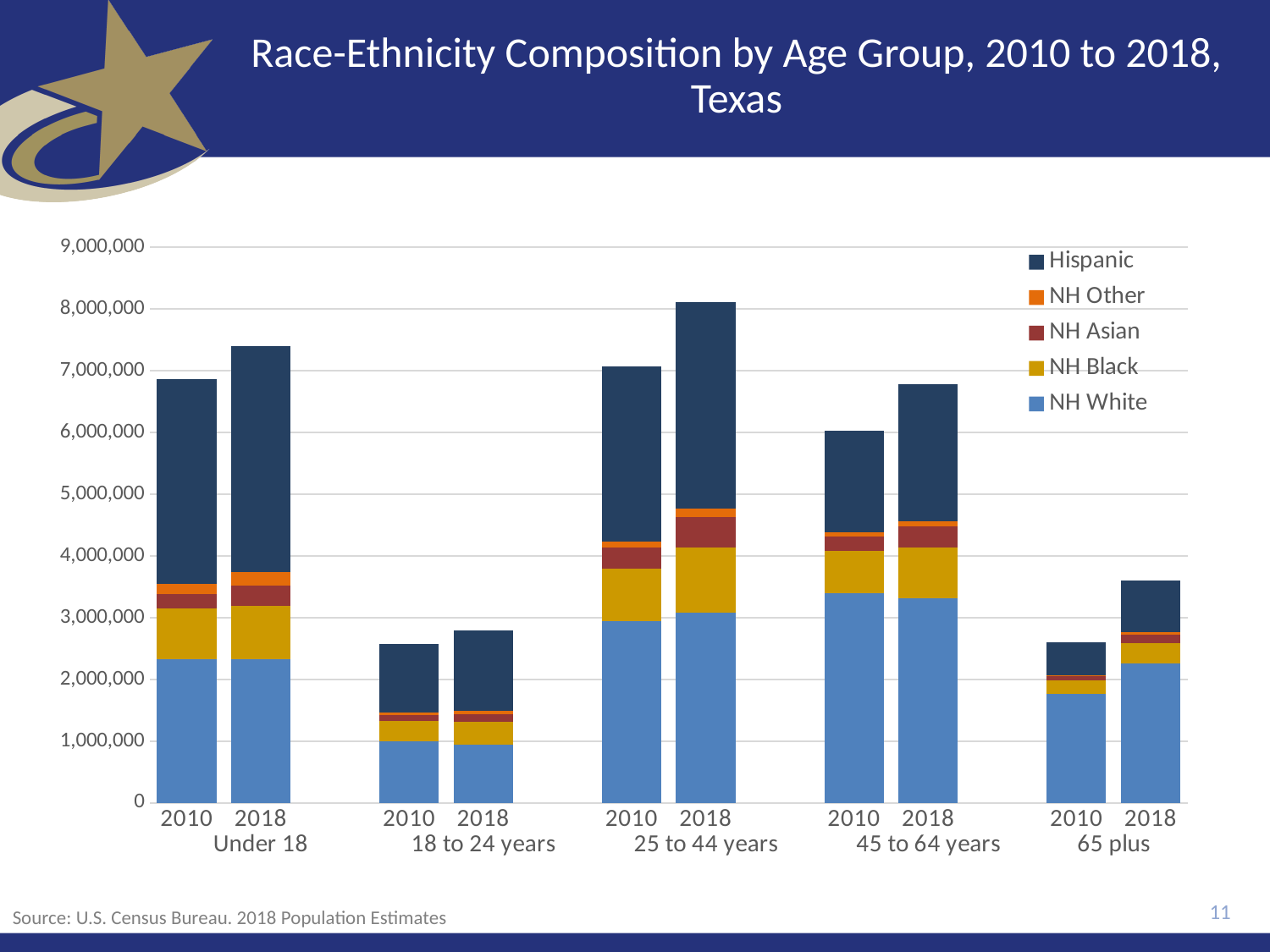
Which bar has the highest total population? 25 to 44 years, 2018 Within each age group, does the total population rise or fall from 2010 to 2018? Rise How many series does the legend list? 5 How many age groups are shown along the x axis? 5 Is the total for 65 plus in 2018 greater or less than 3,000,000? greater Is the total for 45 to 64 years in 2010 greater or less than 5,000,000? greater Is the total for 18 to 24 years in 2010 greater or less than 3,000,000? less What kind of chart is shown on the slide? Stacked bar chart How many bars are plotted in total on the chart? 10 Which series is listed first in the legend? Hispanic Which is larger, the total for Under 18 in 2018 or the total for 45 to 64 years in 2018? Under 18 in 2018